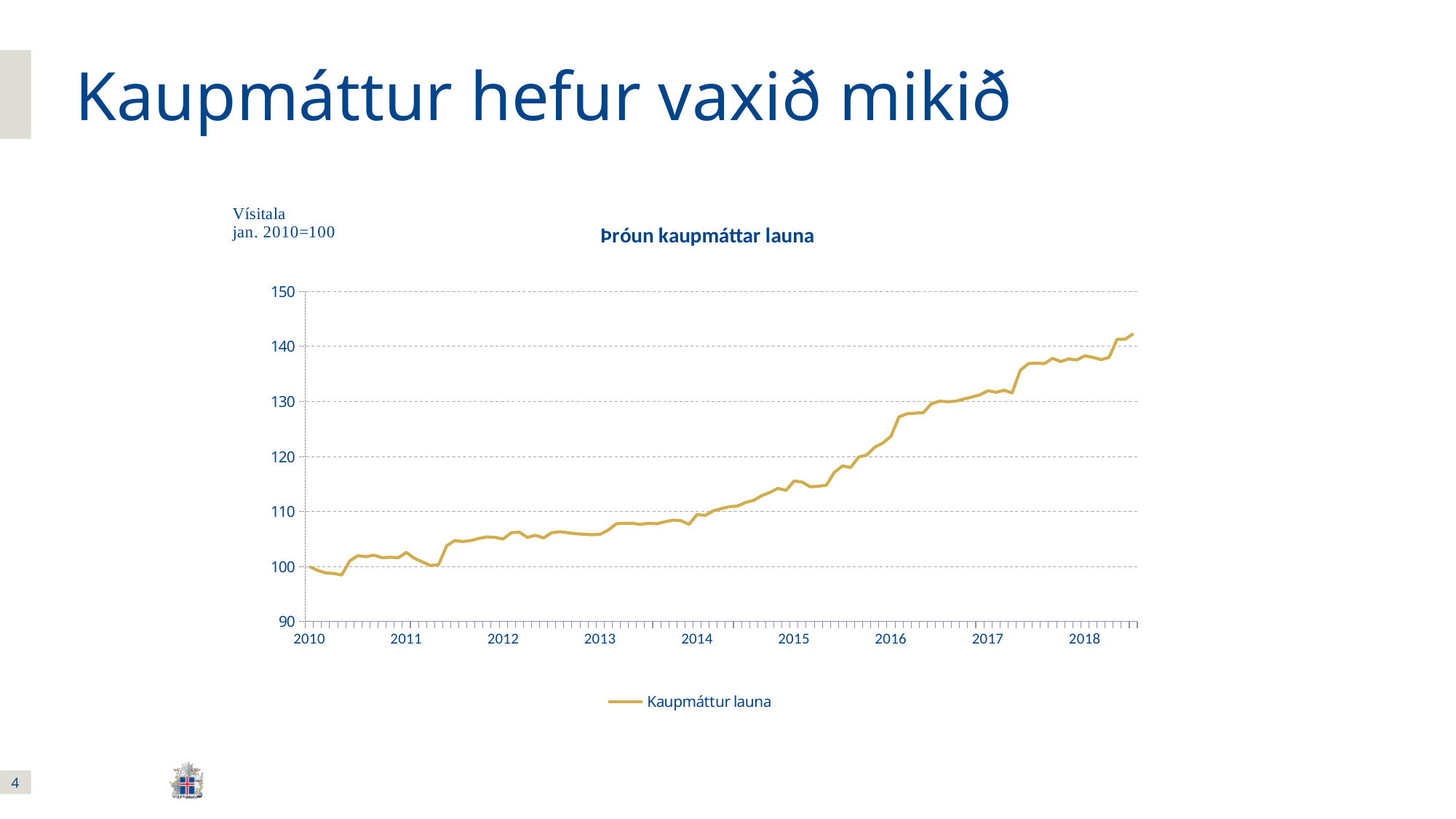
In which year does the line reach its highest value? 2018 What kind of chart is shown on the slide? line chart Is the value of Kaupmáttur launa at the start of 2012 greater or less than 110? less Is the value of Kaupmáttur launa at the start of 2018 greater or less than 130? greater Is the last plotted value of Kaupmáttur launa in 2018 greater or less than 150? less Which is larger, the value of Kaupmáttur launa at the start of 2018 or at the start of 2010? 2018 Does the value of Kaupmáttur launa generally rise or fall from 2010 to 2018? rise What is the name of the series shown in the legend? Kaupmáttur launa What is the title of the chart? Þróun kaupmáttar launa How many series does the legend list? 1 What is the index value of Kaupmáttur launa in January 2010? 100